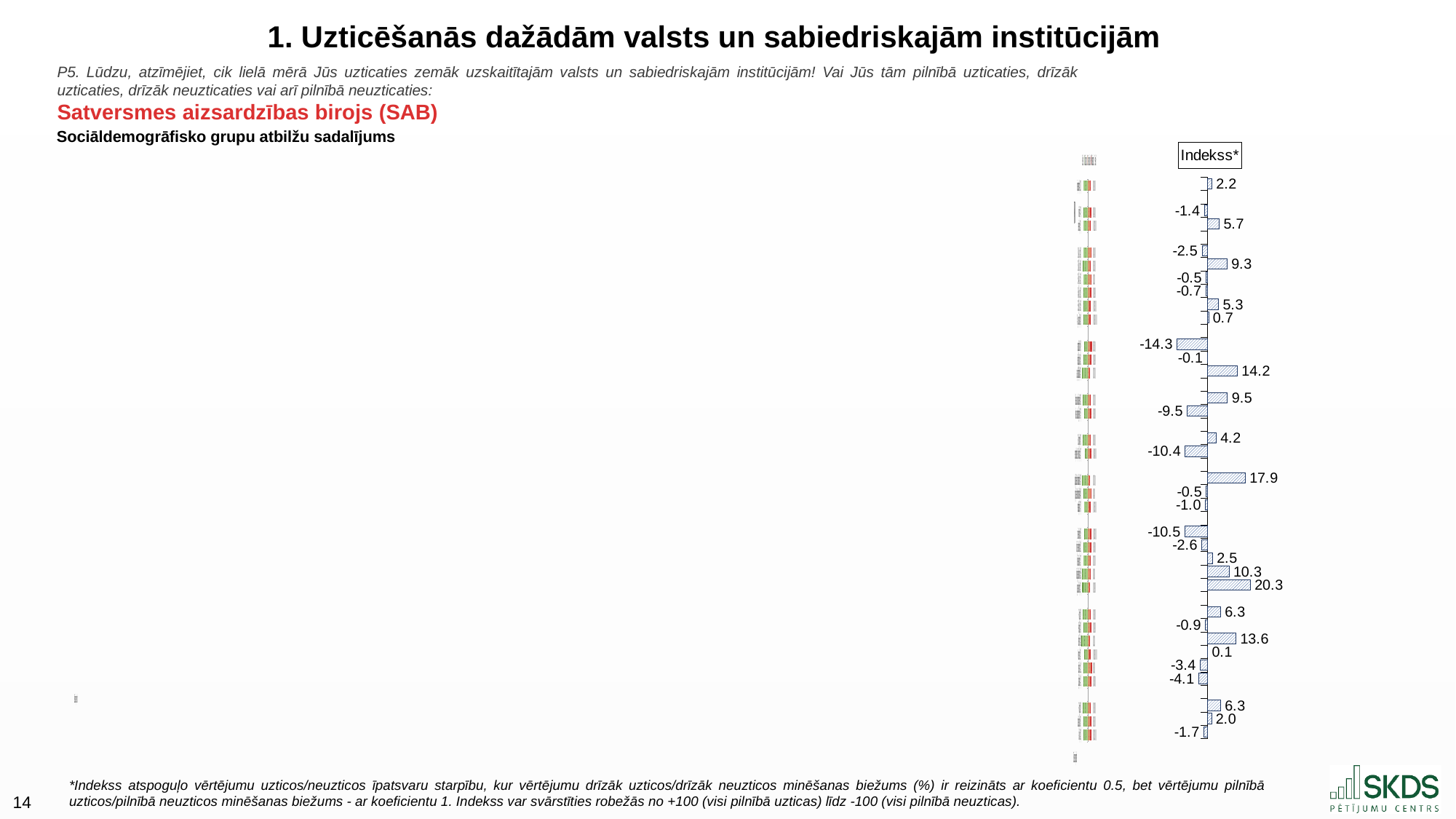
What is the title shown above the chart on the right side of the slide? Indekss* In the 'Indekss*' chart, what is the difference between the highest value (20.3) and the lowest value (-14.3)? 34.6 In the 'Indekss*' chart, what is the value of the bottommost bar? -1.7 In the 'Indekss*' chart, is the highest value greater or less than 20? greater Which institution is named in red on the slide as the subject of the chart? Satversmes aizsardzības birojs (SAB) In the 'Indekss*' chart, what is the lowest value shown? -14.3 In the 'Indekss*' chart, what is the highest value shown? 20.3 In the 'Indekss*' chart, which is larger: the value 14.2 or the value 13.6? 14.2 In the 'Indekss*' chart, what is the value of the topmost bar? 2.2 In the 'Indekss*' chart, what is the second-highest value shown? 17.9 What kind of chart is the 'Indekss*' chart on the right side of the slide? bar chart How many bars are plotted in the 'Indekss*' chart? 33